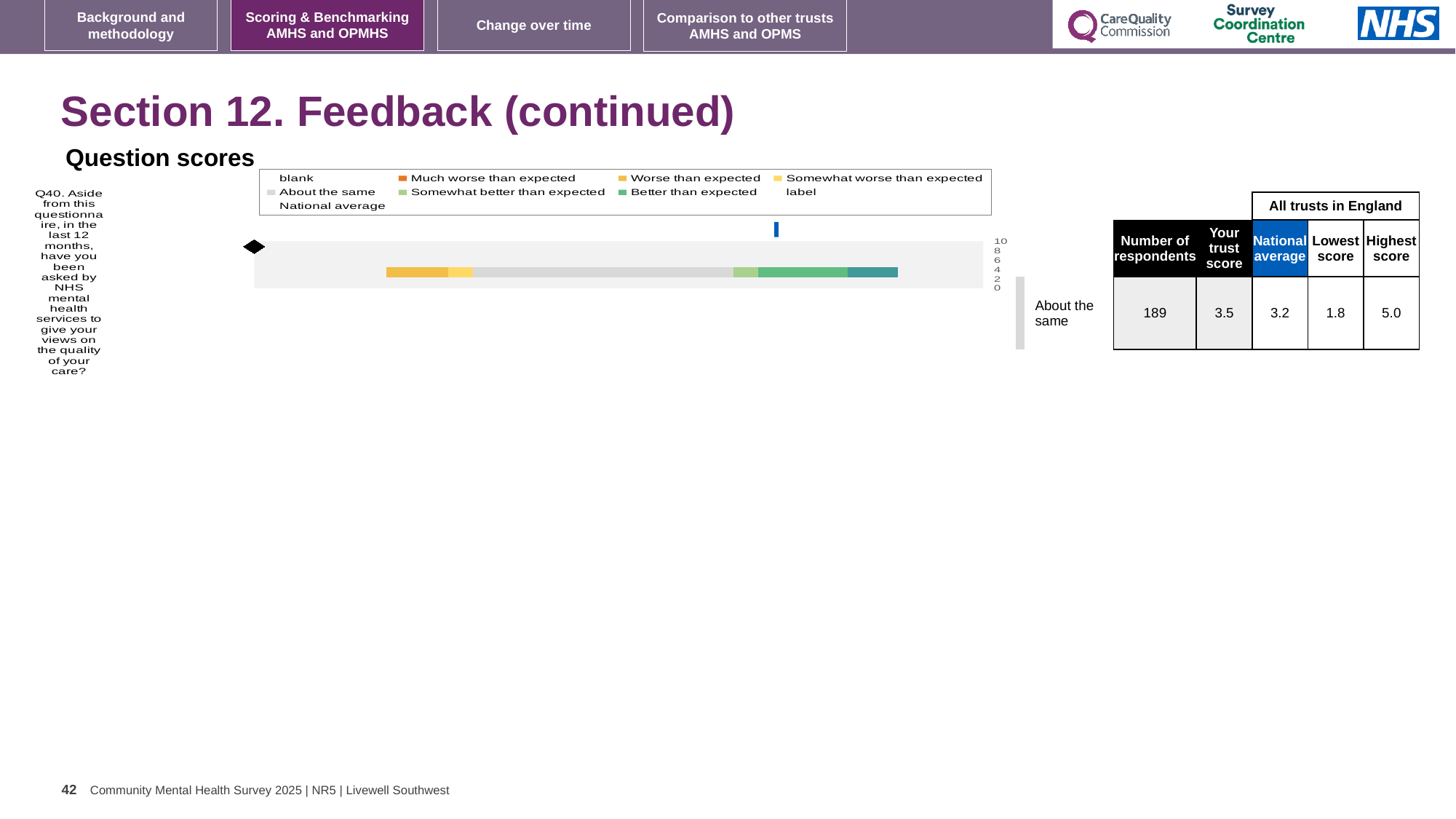
What kind of chart is shown under 'Question scores'? bar chart In the table beside the chart, what is the number of respondents for Q40? 189 In the table beside the chart, what is the highest score among all trusts in England for Q40? 5.0 How many questions (categories) are plotted in the bar chart? 1 How many entries does the chart legend list? 9 What benchmark category label is shown to the right of the Q40 bar? About the same Which question number is plotted in the bar chart? Q40 In the table beside the chart, what is the national average for Q40? 3.2 For Q40, which is larger: your trust score or the national average? Your trust score For Q40, what is the difference between the highest score (5.0) and the lowest score (1.8) in the table? 3.2 In the table beside the chart, what is 'Your trust score' for Q40? 3.5 What colour does the legend use for 'Much worse than expected'? orange